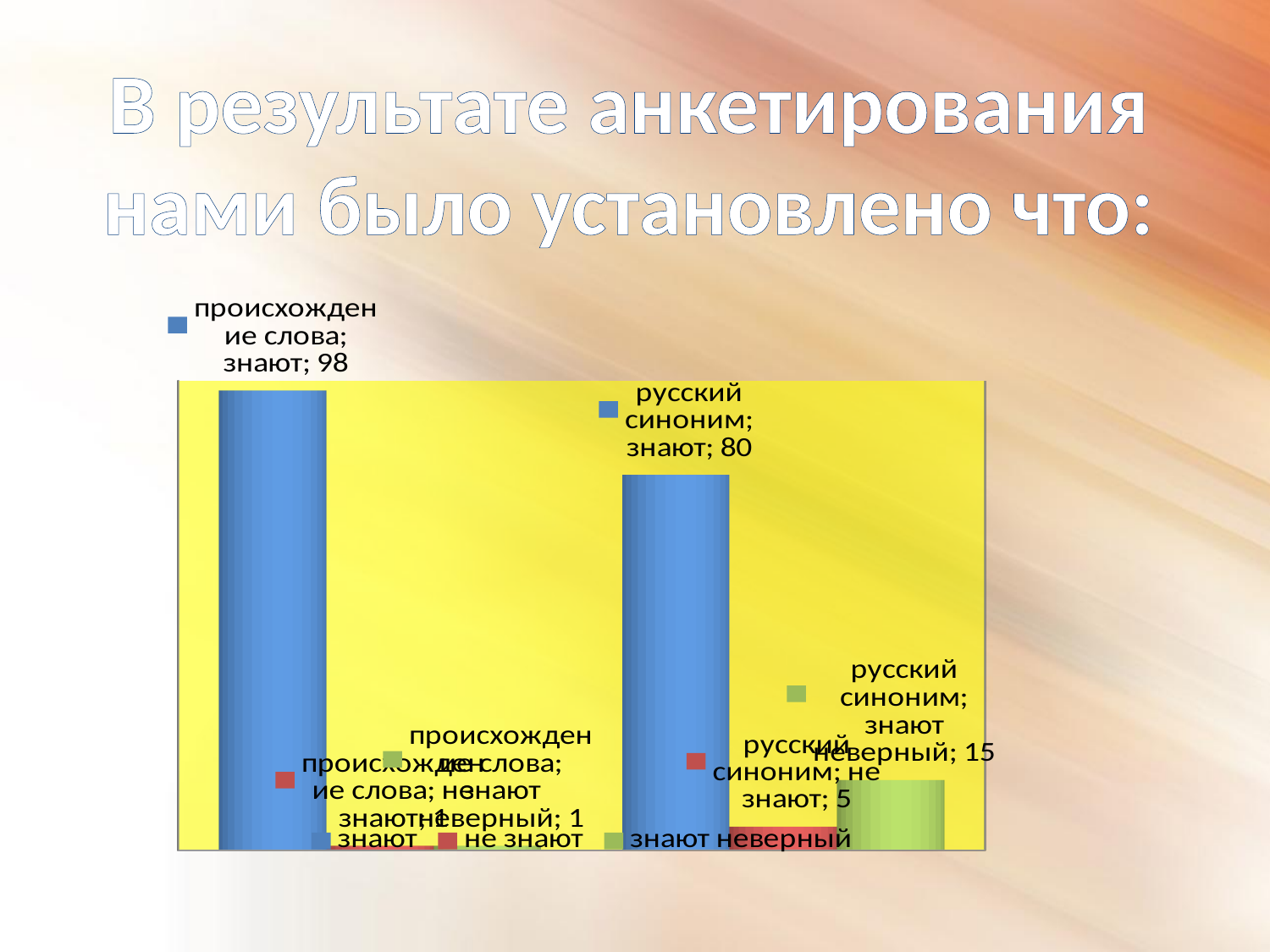
Which series has the highest value in the "русский синоним" category? знают What value is shown for "знают" in the "происхождение слова" category? 98 What kind of chart is shown on the slide? bar chart What value is shown for "знают неверный" in the "русский синоним" category? 15 What value is shown for "знают" in the "русский синоним" category? 80 Which series has the lowest value in the "русский синоним" category? не знают What colour are the "знают" bars? blue What is the difference between the "знают" values for "происхождение слова" and "русский синоним"? 18 Which is larger: "знают неверный" for "русский синоним" or "не знают" for "русский синоним"? знают неверный for русский синоним How many series does the legend list? 3 What value is shown for "не знают" in the "русский синоним" category? 5 What value is shown for "не знают" in the "происхождение слова" category? 1